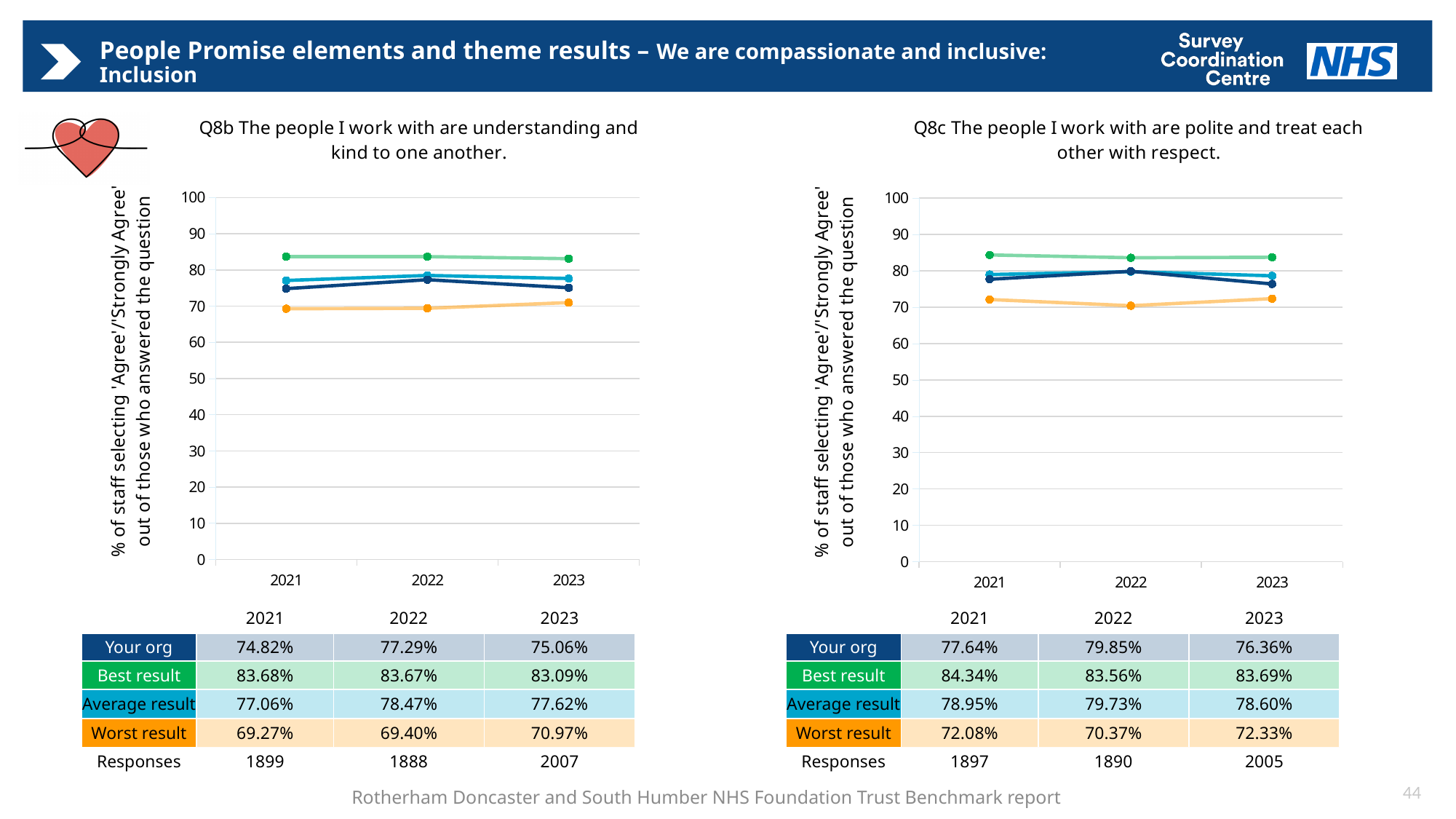
What kind of chart is the Q8c chart? Line chart On the Q8b chart, in which year was the 'Your org' value highest? 2022 How many years are shown on the x axis of the Q8b chart? 3 On the Q8c chart, what was the 'Average result' value in 2022? 79.73% On the Q8c chart, what was the 'Worst result' value in 2021? 72.08% On the Q8c chart, how many responses were recorded in 2023? 2005 On the Q8b chart, what was the 'Best result' value in 2023? 83.09% On the Q8b chart, is the 'Worst result' value for 2021 greater or less than 70? less On the Q8b chart, what was the 'Your org' value in 2022? 77.29% On the Q8b chart, what is the difference between the 'Best result' and 'Your org' values in 2021? 8.86% On the Q8c chart, which is larger in 2023: the 'Your org' value or the 'Average result' value? Average result On the Q8c chart, in which year was the 'Worst result' value lowest? 2022